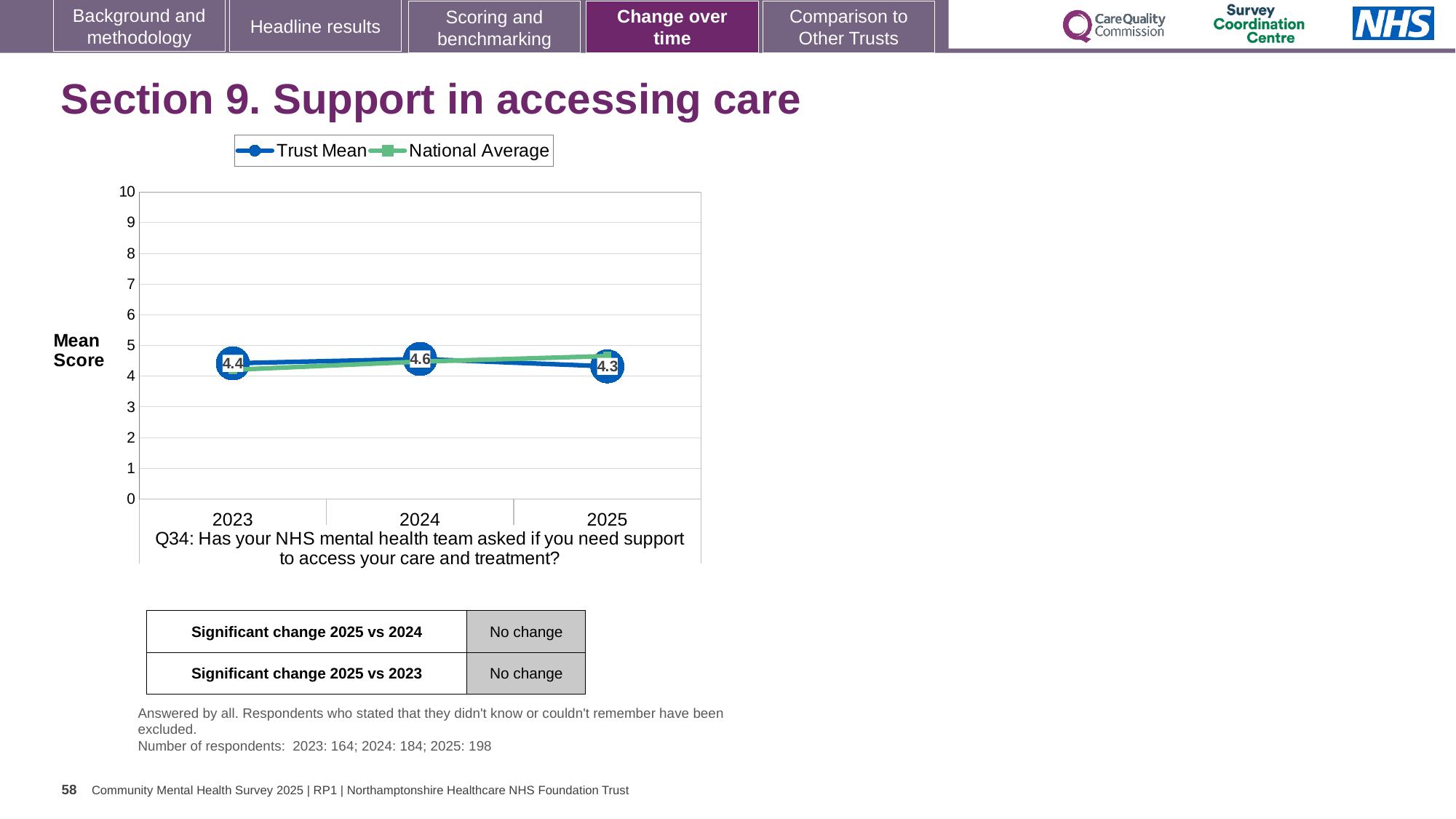
How many series does the legend list? 2 In which year is the Trust Mean highest? 2024 What is the difference between the Trust Mean in 2024 and in 2023? 0.2 What is the Trust Mean value for 2025? 4.3 Which year has the larger Trust Mean, 2023 or 2025? 2023 How many years are plotted on the x axis? 3 What is the difference between the Trust Mean in 2024 and in 2025? 0.3 Is the Trust Mean value for 2025 greater or less than 5? less What is the Trust Mean value for 2024? 4.6 In which year is the Trust Mean lowest? 2025 What kind of chart is shown on the slide? line chart What is the Trust Mean value for 2023? 4.4